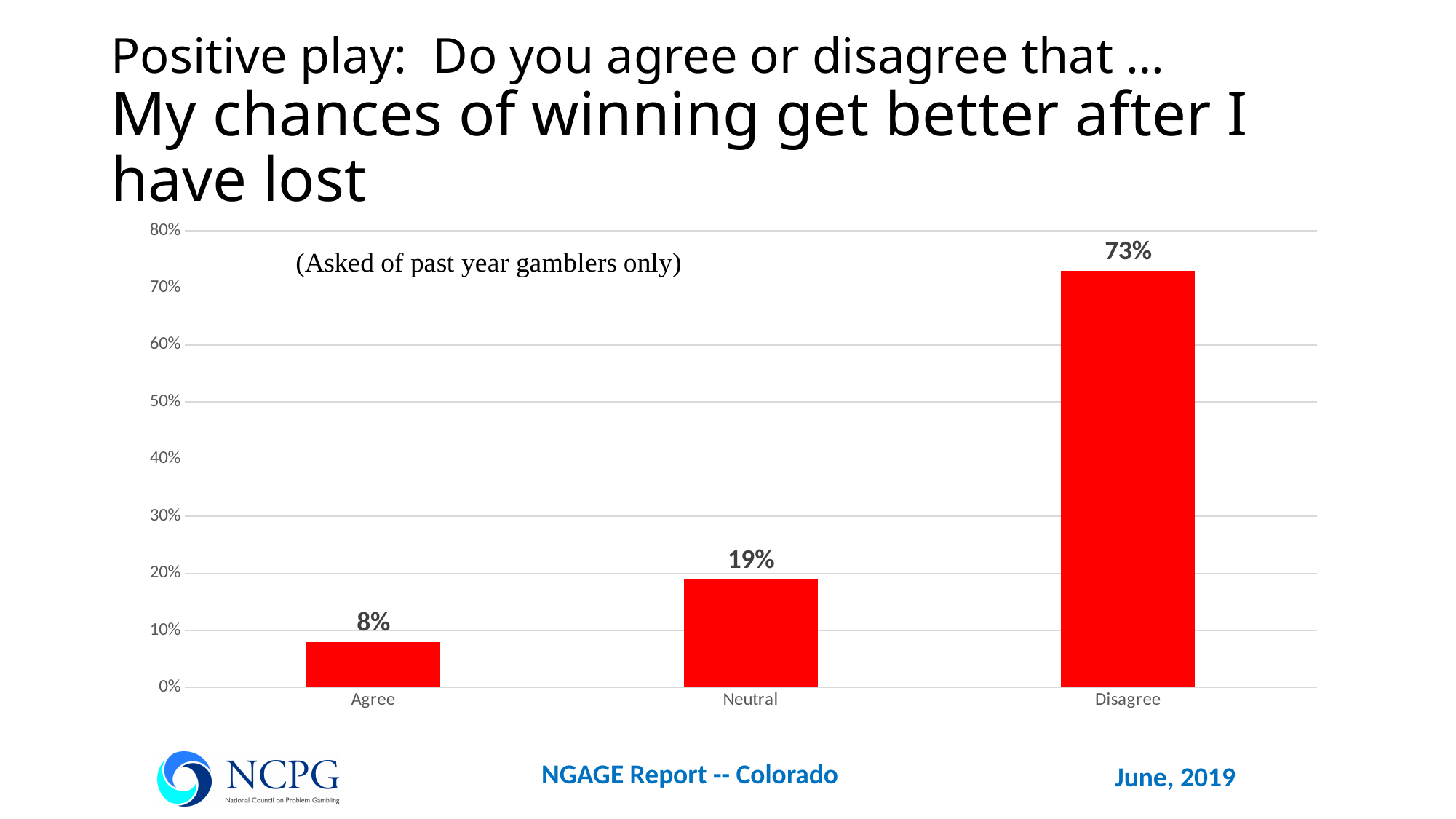
What note is printed inside the chart area about who was asked the question? (Asked of past year gamblers only) What percentage of respondents chose Agree? 8% What is the difference in percentage points between Disagree and Agree? 65 percentage points What is the difference in percentage points between Neutral and Agree? 11 percentage points How many response categories are shown on the x axis? 3 What percentage of respondents chose Disagree? 73% What kind of chart is shown on the slide? Bar chart Is the value for Disagree greater or less than 70%? greater Which is larger, the value for Neutral or the value for Agree? Neutral Which response category has the highest value? Disagree What percentage of respondents chose Neutral? 19% Which response category has the lowest value? Agree